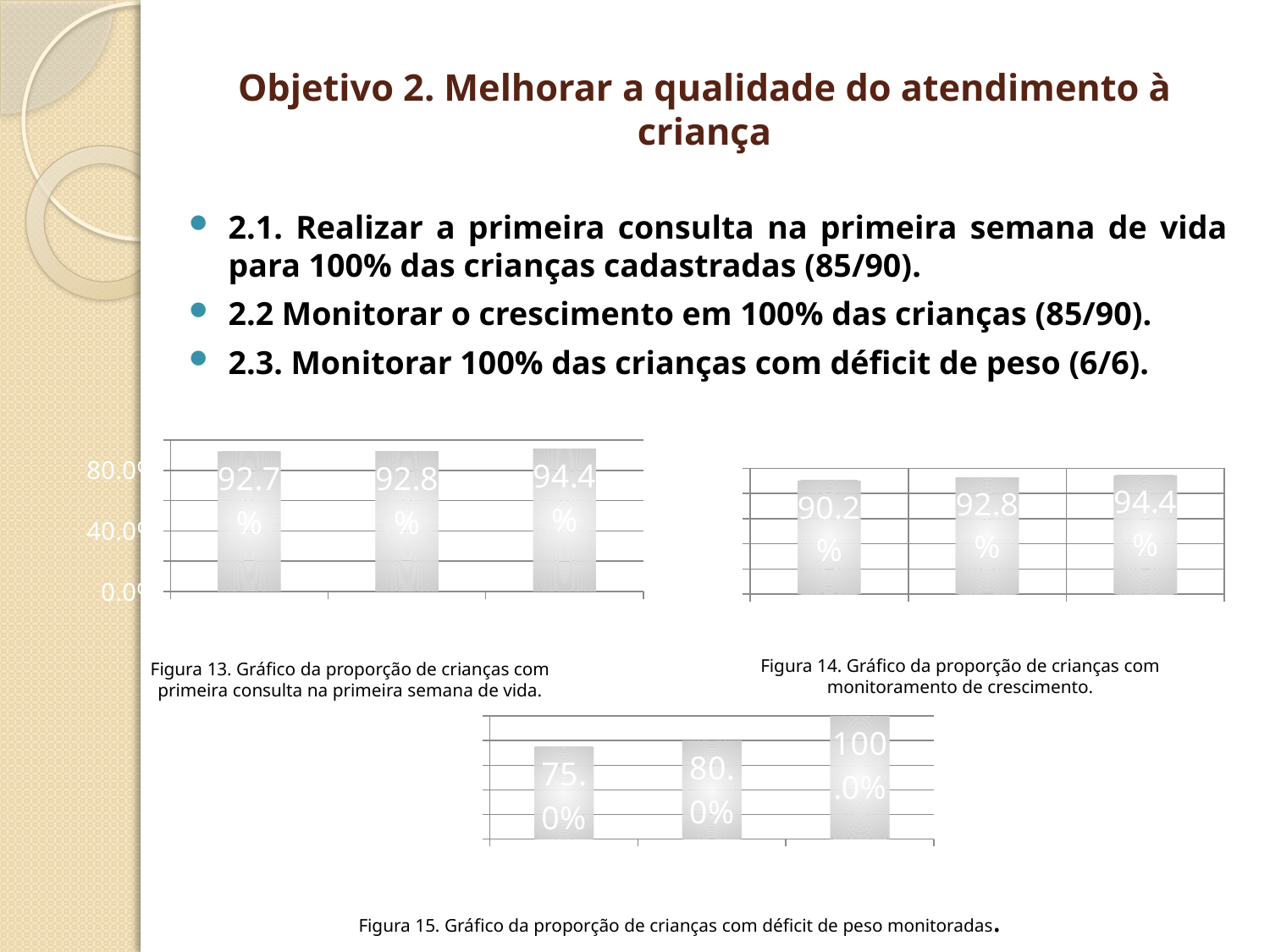
In Figura 14, what is the difference between the third bar and the first bar? 4.2% In Figura 13, what value is shown on the third (rightmost) bar? 94.4% In Figura 15 (proporção de crianças com déficit de peso monitoradas), what value is shown on the third bar? 100.0% In Figura 14, which bar has the lowest value? the first bar (90.2%) In Figura 14 (proporção de crianças com monitoramento de crescimento), what value is shown on the first bar? 90.2% How many bars does the chart in Figura 13 have? 3 In Figura 15, what is the difference between the third bar and the first bar? 25.0% In Figura 13 (proporção de crianças com primeira consulta na primeira semana de vida), what value is shown on the first bar? 92.7% What kind of chart is Figura 15? bar chart In Figura 15, what value is shown on the first bar? 75.0% In Figura 15, do the values rise or fall from left to right? rise In Figura 15, which bar has the highest value? the third bar (100.0%)